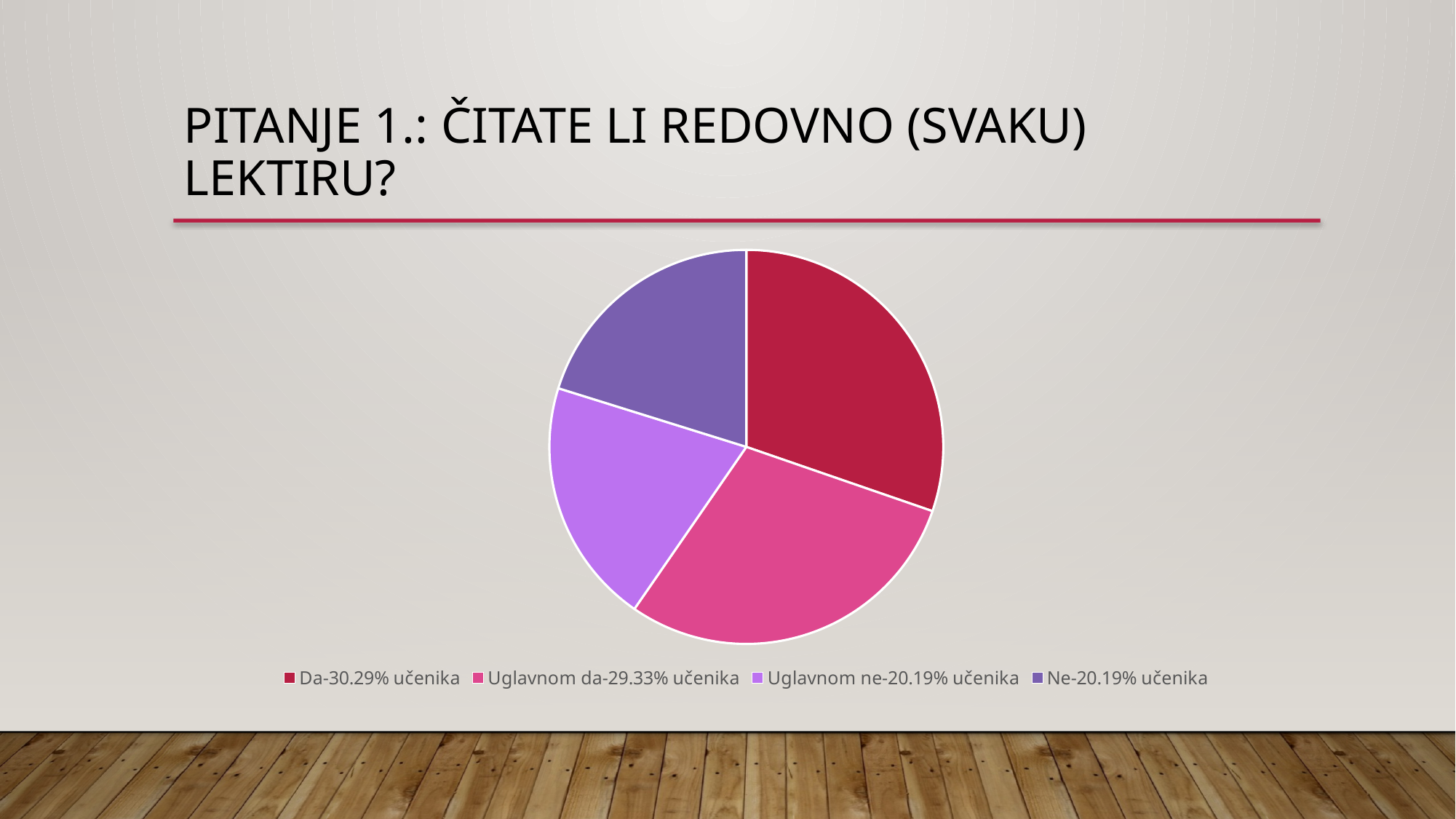
How many slices does the pie chart have? 4 Which is larger, the share for "Da" or the share for "Uglavnom da"? Da What is the difference in percentage points between "Da" and "Ne"? 10.10 What is the title of the slide containing the pie chart? Pitanje 1.: Čitate li redovno (svaku) lektiru? What is the difference in percentage points between "Da" and "Uglavnom da"? 0.96 What percentage of students answered "Ne"? 20.19% What percentage of students answered "Uglavnom da"? 29.33% What percentage of students answered "Da"? 30.29% What percentage of students answered "Uglavnom ne"? 20.19% Which two answers have the same share of the pie? Uglavnom ne and Ne Which answer has the largest share of the pie? Da What kind of chart is shown on the slide? pie chart